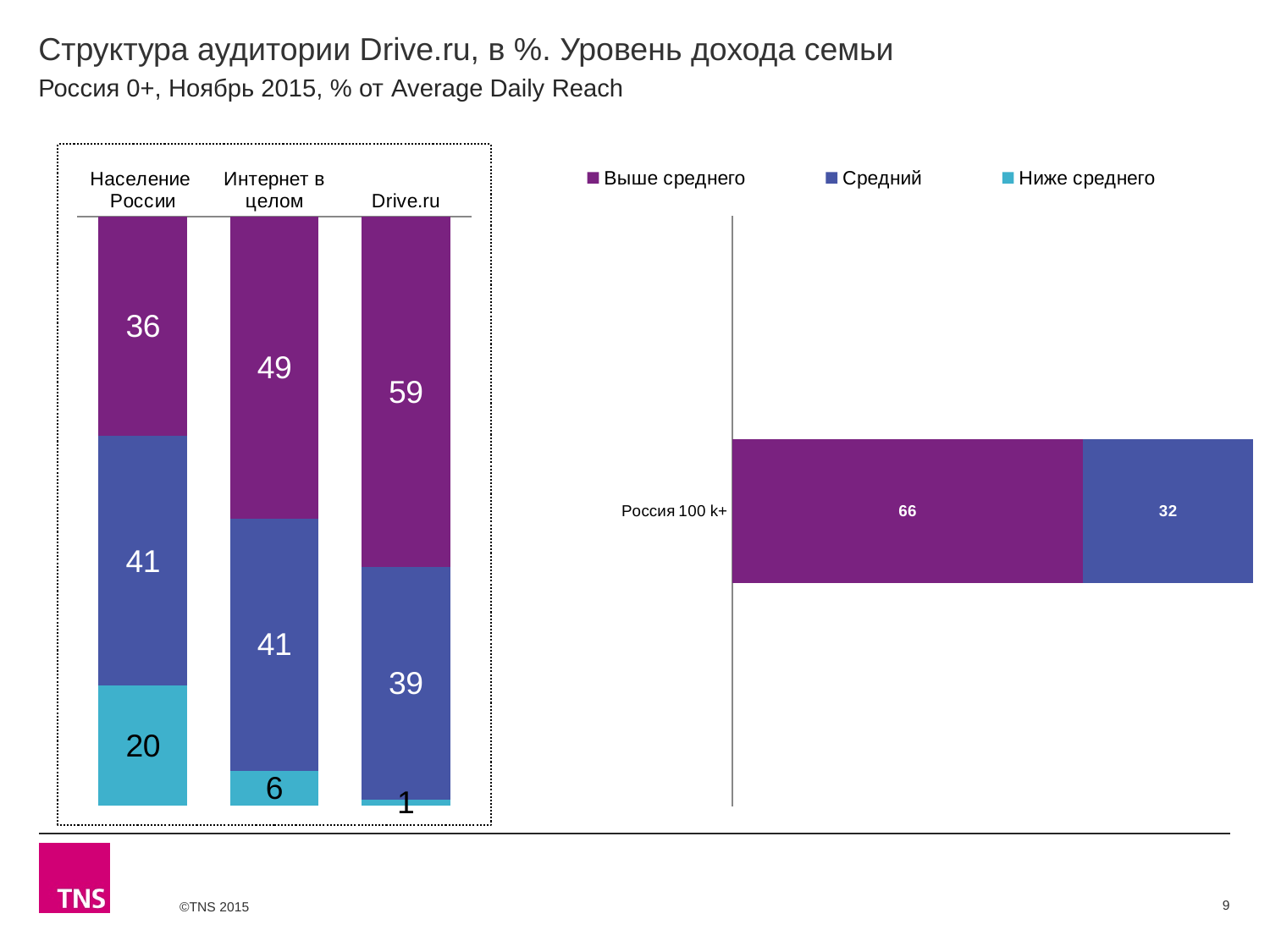
In the left chart, which is larger: the 'Ниже среднего' value for Население России or for Интернет в целом? Население России How many categories are shown in the left chart? 3 In the left chart, what is the difference between the 'Выше среднего' values for Drive.ru and Население России? 23 In the right chart, what is the value of the 'Выше среднего' segment for Россия 100 k+? 66 In the left chart, what is the value of the 'Ниже среднего' segment for Население России? 20 In the left chart, which category has the highest 'Выше среднего' value? Drive.ru In the right chart, what is the value of the 'Средний' segment for Россия 100 k+? 32 In the left chart, what is the value of the 'Средний' segment for Интернет в целом? 41 In the left chart, what is the value of the 'Выше среднего' segment for Drive.ru? 59 What type of chart is the right chart? Stacked bar chart In the left chart, which category has the lowest 'Ниже среднего' value? Drive.ru How many series does the legend list? 3